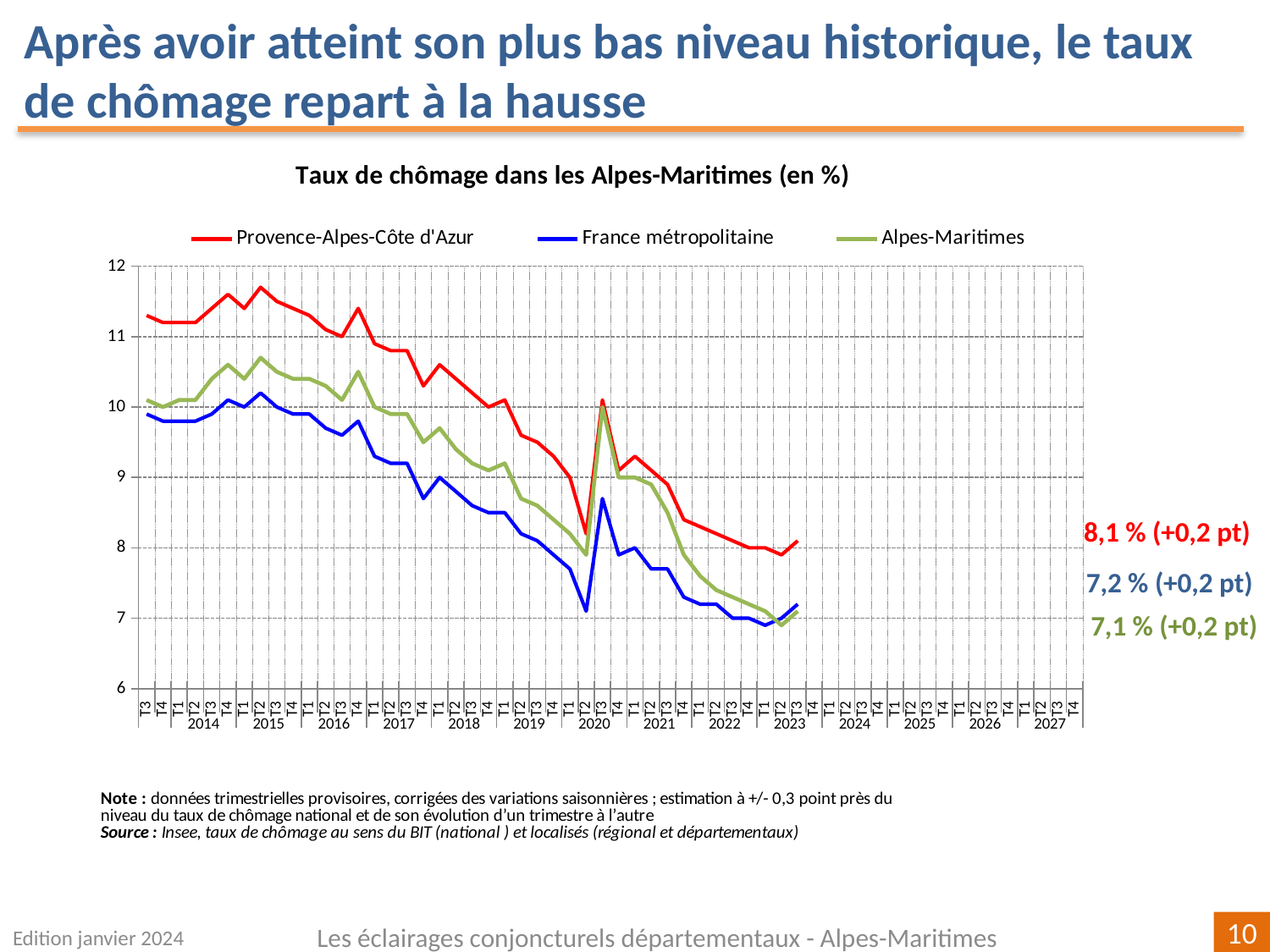
Is the value for Provence-Alpes-Côte d'Azur in T2 2015 greater or less than 11? greater What is the latest unemployment rate shown for Alpes-Maritimes? 7,1 % What is the difference between the latest rates for Provence-Alpes-Côte d'Azur and France métropolitaine? 0,9 pt What is the title of the chart? Taux de chômage dans les Alpes-Maritimes (en %) How many series does the legend list? 3 Which series has the lowest latest value according to the labels? Alpes-Maritimes What is the latest unemployment rate shown for France métropolitaine? 7,2 % What is the latest unemployment rate shown for Provence-Alpes-Côte d'Azur? 8,1 % Is the value for France métropolitaine in T2 2020 greater or less than 8? less What kind of chart is shown on the slide? line chart By how much did the Alpes-Maritimes rate change in the latest quarter, according to the label? +0,2 pt Which series has the highest values across the whole period? Provence-Alpes-Côte d'Azur